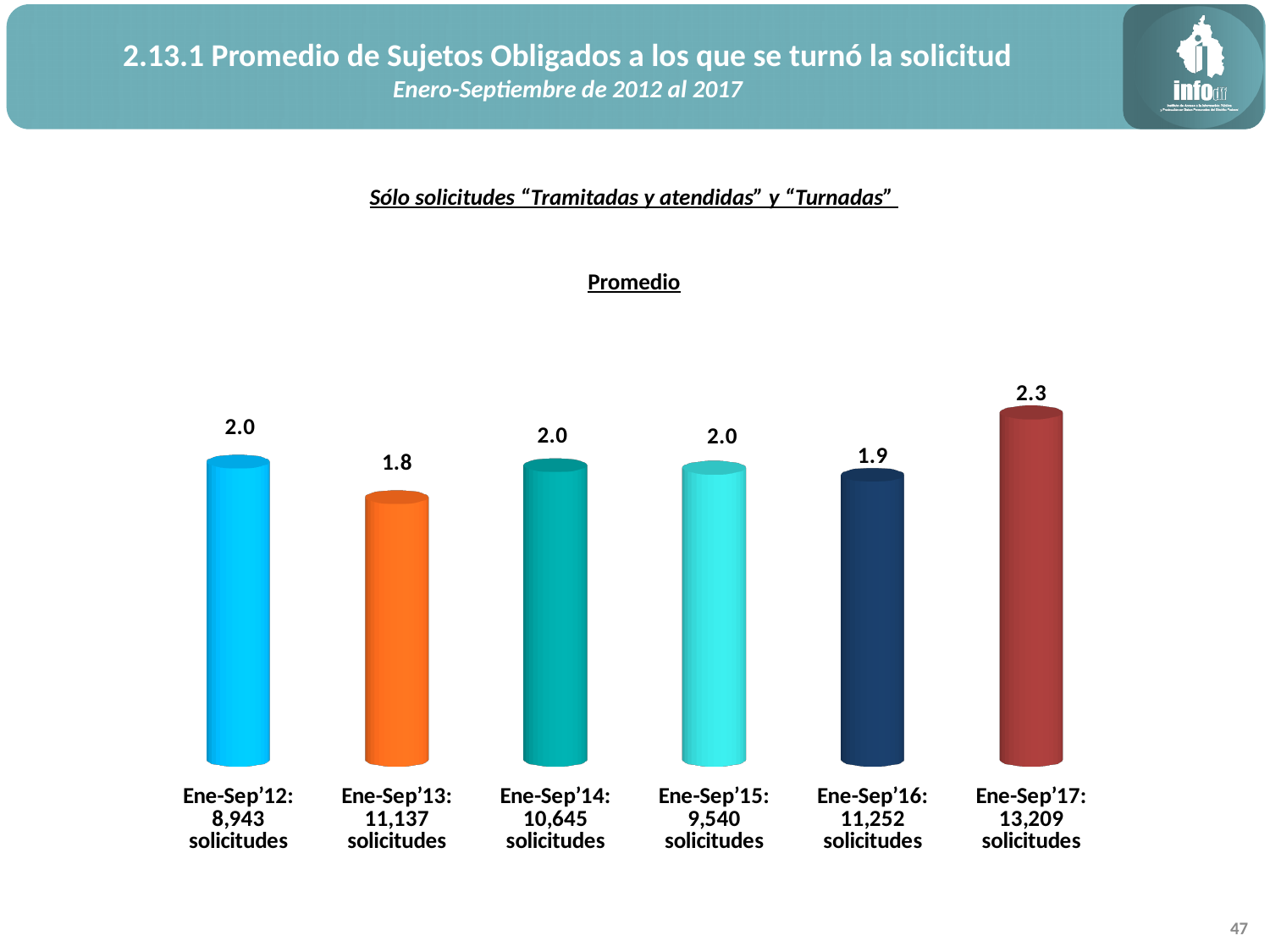
Which period has the lowest value? Ene-Sep'13 How many periods are shown in the chart? 6 What is the value for Ene-Sep'12? 2.0 What is the label above the chart? Promedio What is the value for Ene-Sep'16? 1.9 What is the difference between the values for Ene-Sep'17 and Ene-Sep'13? 0.5 Which period has the highest value? Ene-Sep'17 What kind of chart is shown on the slide? Bar chart How many solicitudes are listed under the Ene-Sep'17 label? 13,209 Which is larger, the value for Ene-Sep'16 or the value for Ene-Sep'17? Ene-Sep'17 What is the value for Ene-Sep'17? 2.3 What is the value for Ene-Sep'13? 1.8